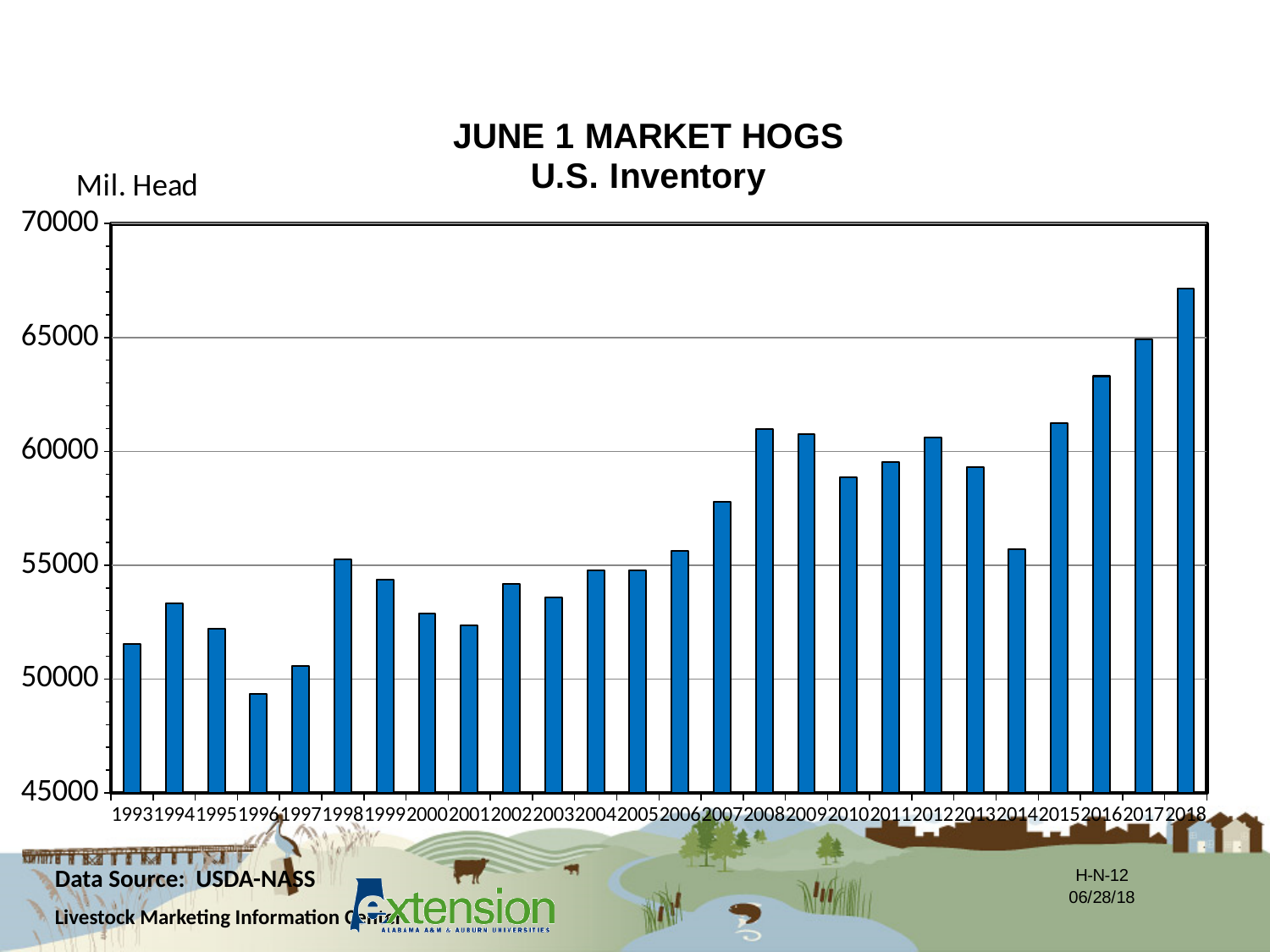
Do the values rise or fall from 2014 to 2018? Rise Is the value for 1996 greater or less than 50000? less Is the value for 2008 greater or less than 60000? greater What unit is shown on the y axis label of the chart? Mil. Head How many years are plotted on the x axis of the chart? 26 Which year has the larger inventory, 1994 or 1995? 1994 What kind of chart is shown on the slide? Bar chart Which year has the lowest June 1 market hog inventory? 1996 Is the value for 2013 greater or less than 60000? less Which year has the highest June 1 market hog inventory? 2018 Which year has the larger inventory, 2014 or 2015? 2015